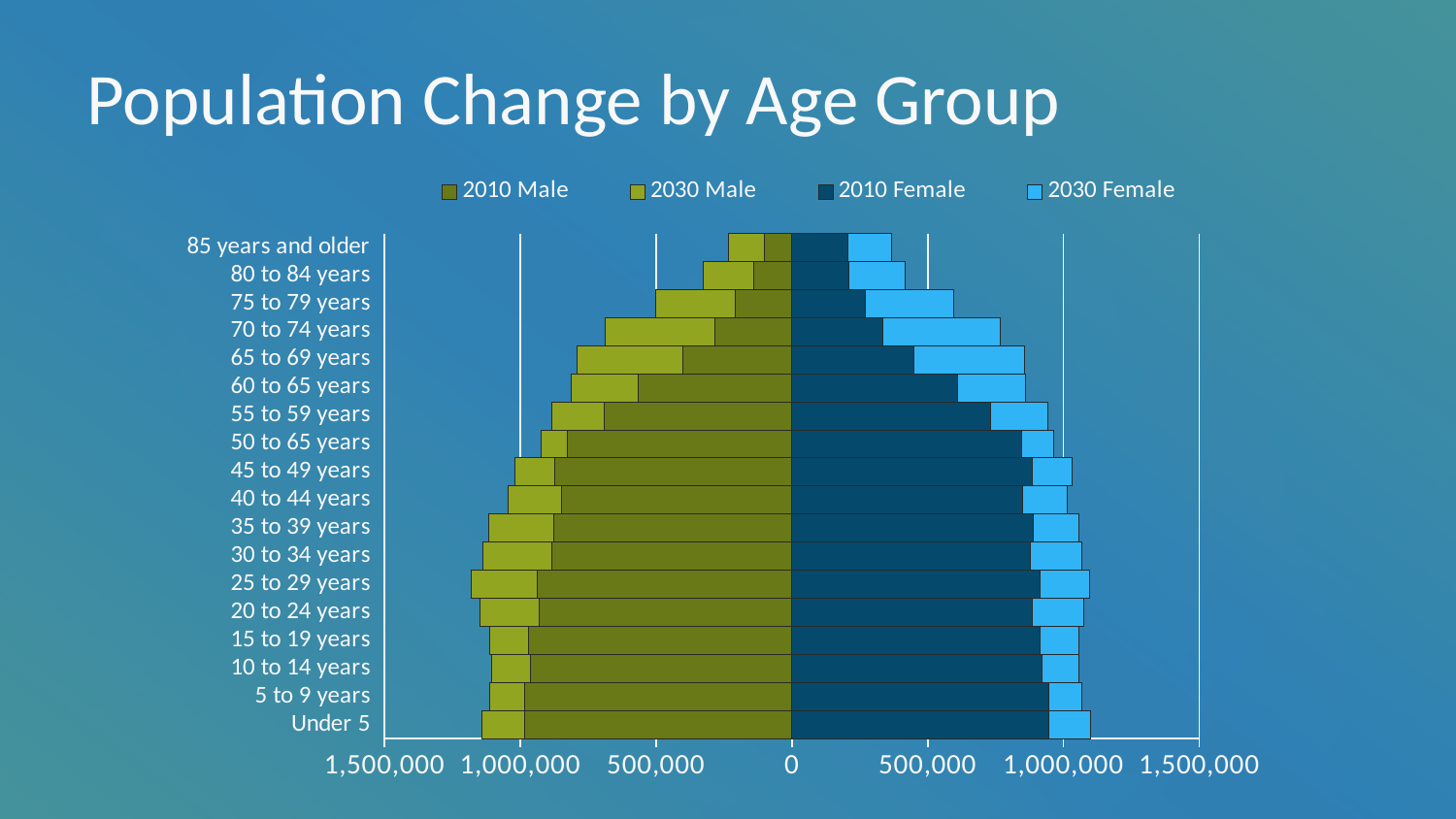
How many series does the legend list? 4 What kind of chart is shown on the slide? bar chart How many age groups are shown on the chart? 18 Is the 2030 Male value for 25 to 29 years greater or less than 1,000,000? less What is the title of the chart? Population Change by Age Group Do the 2010 Female bars get longer or shorter moving from Under 5 up to 85 years and older? shorter Which age group has the smallest 2010 Female value? 85 years and older Which age group has the smallest 2010 Male value? 85 years and older Which series are listed in the legend? 2010 Male, 2030 Male, 2010 Female, 2030 Female Is the 2010 Female value for 85 years and older greater or less than 500,000? less For 85 years and older, which is larger: the 2010 Female value or the 2030 Female value? 2010 Female